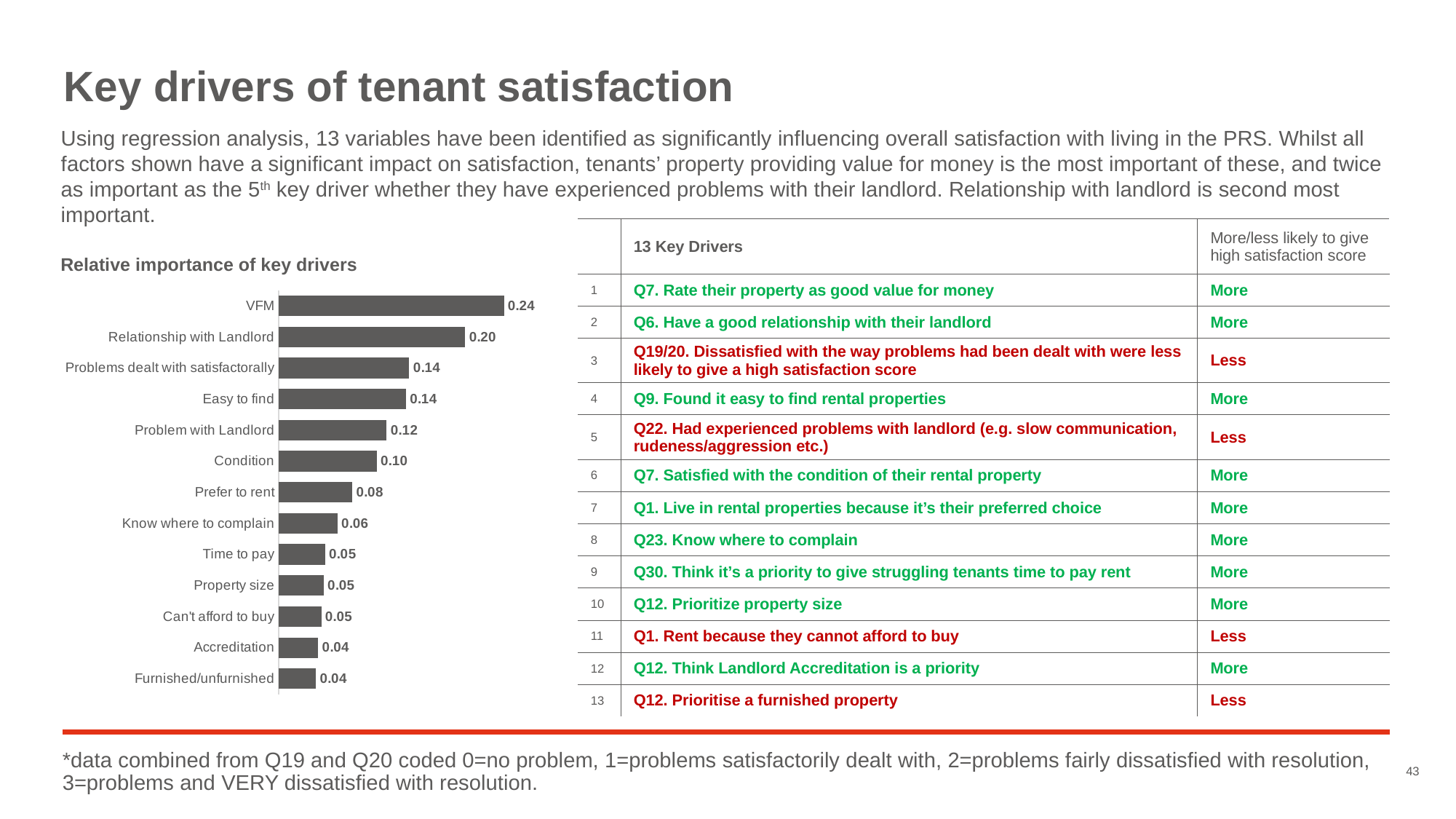
What is the relative importance value for Relationship with Landlord? 0.20 What is the relative importance value for Condition? 0.10 Which has a higher relative importance, Condition or Prefer to rent? Condition What is the difference in relative importance between VFM and Problem with Landlord? 0.12 Which has a higher relative importance, Problem with Landlord or Time to pay? Problem with Landlord What type of chart is used to show the relative importance of key drivers? Bar chart What is the difference in relative importance between Relationship with Landlord and Prefer to rent? 0.12 How many key drivers are shown in the bar chart? 13 What is the relative importance value for VFM? 0.24 What is the title of the chart? Relative importance of key drivers Which key driver has the highest relative importance? VFM What is the relative importance value for Know where to complain? 0.06